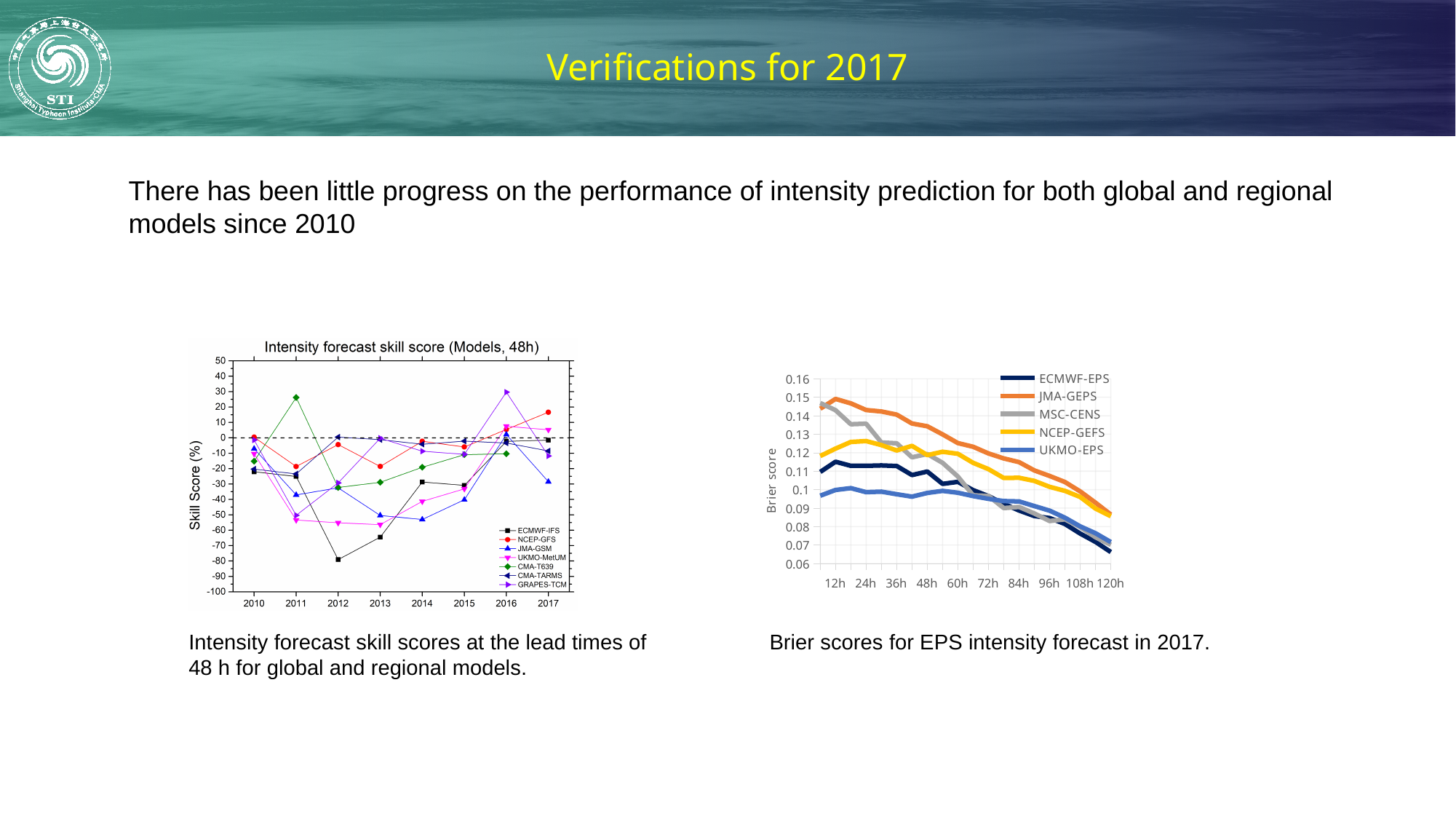
In the right chart (Brier scores for EPS intensity forecast), which series has the lowest Brier score at 12h? UKMO-EPS In the left chart, 'Intensity forecast skill score (Models, 48h)', which model has the lowest skill score in 2012? ECMWF-IFS How many years are shown on the x axis of the left chart, 'Intensity forecast skill score (Models, 48h)'? 8 In the left chart, 'Intensity forecast skill score (Models, 48h)', which is larger in 2017: the skill score for NCEP-GFS or for JMA-GSM? NCEP-GFS In the right chart (Brier scores for EPS intensity forecast), is the Brier score for JMA-GEPS at 12h greater or less than 0.14? greater What type of chart is the 'Intensity forecast skill score (Models, 48h)' chart on the left? line chart How many series does the legend of the right chart (Brier scores for EPS intensity forecast) list? 5 How many series does the legend of the left chart, 'Intensity forecast skill score (Models, 48h)', list? 7 What is the y-axis label of the right chart (Brier scores for EPS intensity forecast)? Brier score In the right chart (Brier scores for EPS intensity forecast), do the Brier scores generally rise or fall as lead time increases from 12h to 120h? fall How many lead times are labelled on the x axis of the right chart (Brier scores for EPS intensity forecast)? 10 In the left chart, 'Intensity forecast skill score (Models, 48h)', is the skill score for ECMWF-IFS in 2012 greater or less than -50? less